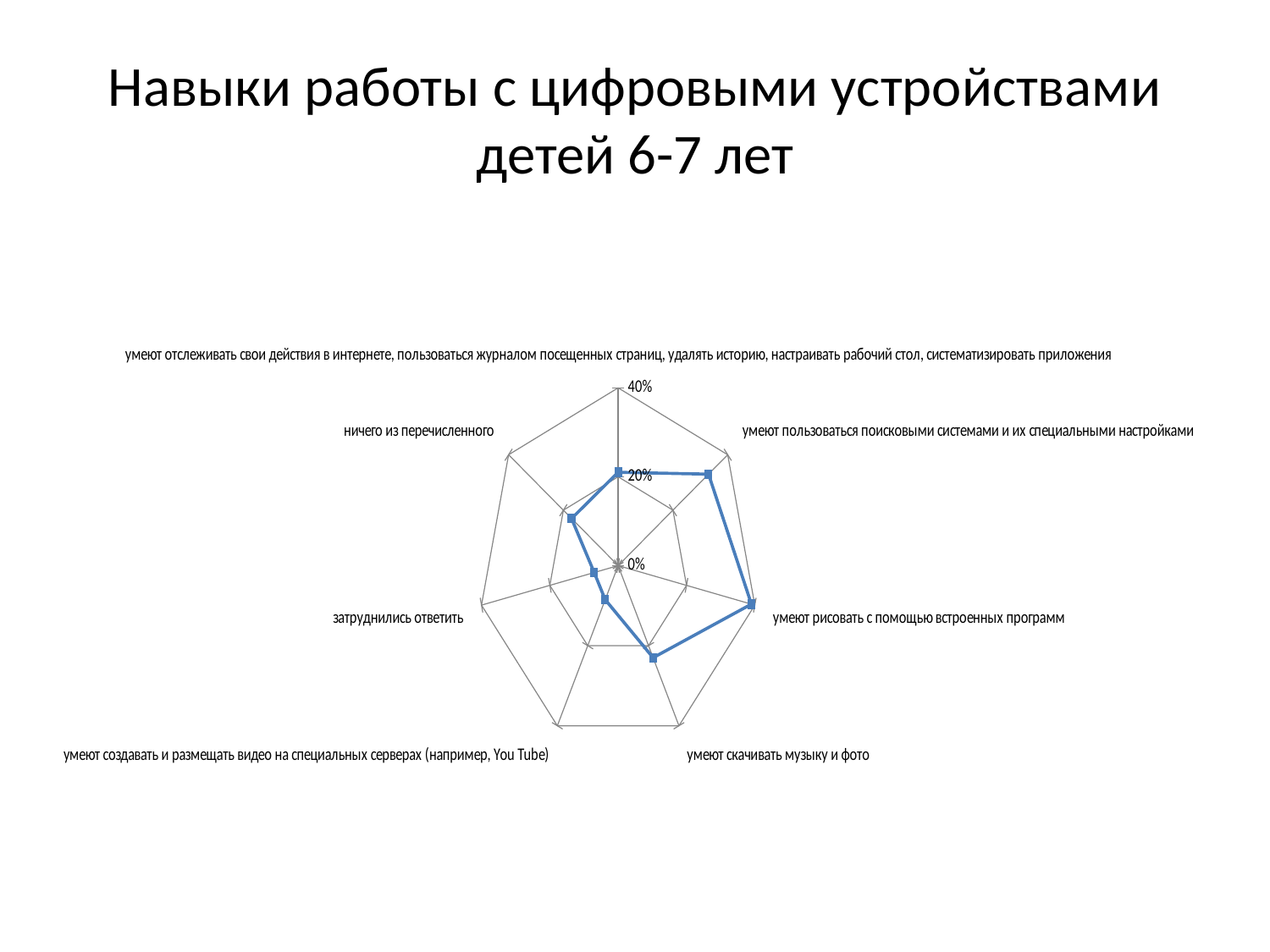
Is the value for "умеют рисовать с помощью встроенных программ" greater or less than 20%? greater Which is larger: the value for "умеют пользоваться поисковыми системами и их специальными настройками" or for "умеют создавать и размещать видео на специальных серверах (например, You Tube)"? умеют пользоваться поисковыми системами и их специальными настройками What is the highest value marked on the chart's axis scale? 40% Which category has the highest value on the chart? умеют рисовать с помощью встроенных программ Is the value for "умеют пользоваться поисковыми системами и их специальными настройками" greater or less than 20%? greater How many categories (axes) does the radar chart have? 7 Is the value for "затруднились ответить" greater or less than 20%? less What is the title of the slide containing the chart? Навыки работы с цифровыми устройствами детей 6-7 лет What kind of chart is shown on the slide? radar chart Which is larger: the value for "умеют рисовать с помощью встроенных программ" or for "затруднились ответить"? умеют рисовать с помощью встроенных программ